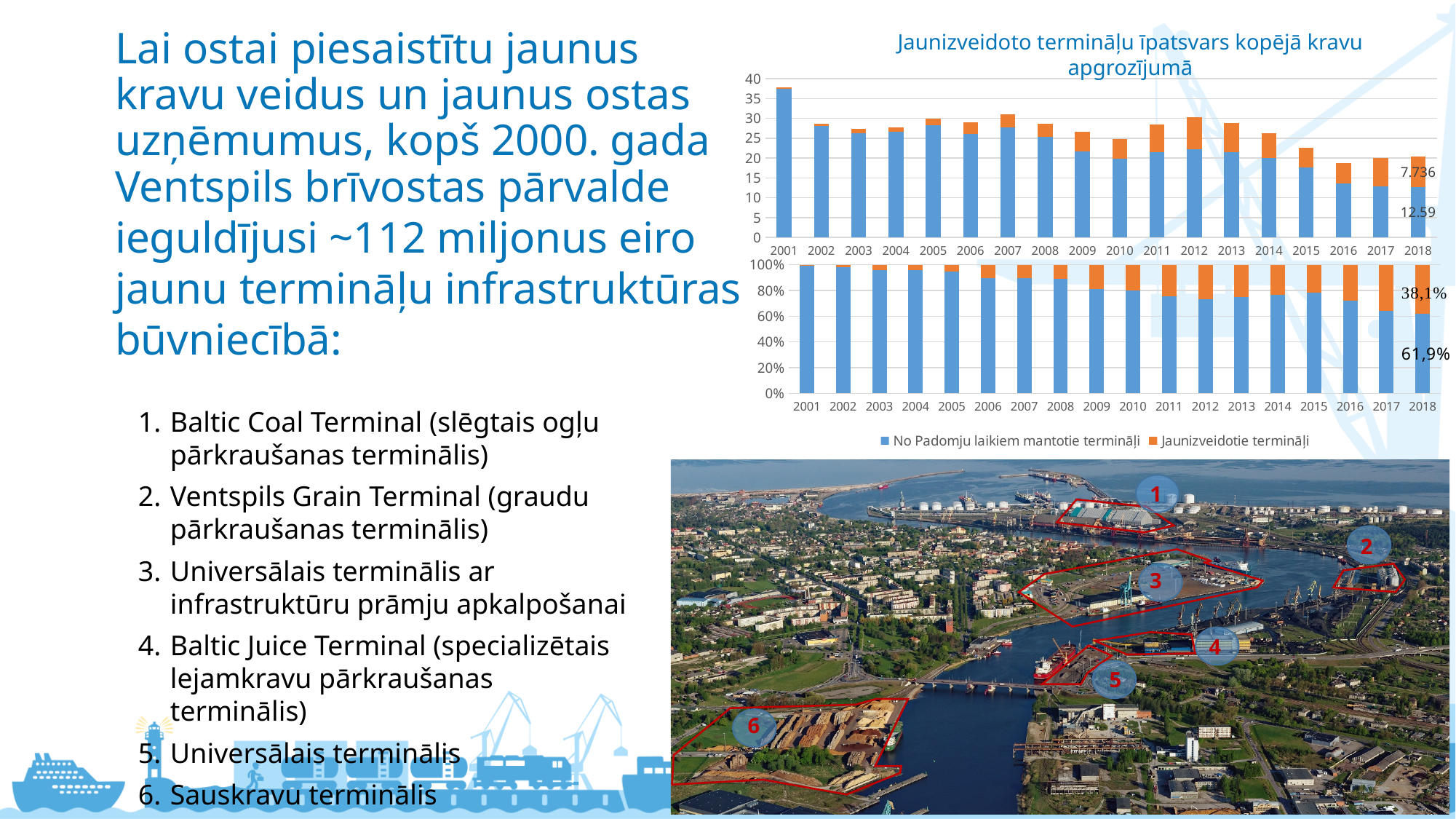
In the top chart, what is the value for Jaunizveidotie termināļi in 2018? 7.736 In the top chart, which year has the highest total bar? 2001 In the top chart, what is the difference between the 2018 values of No Padomju laikiem mantotie termināļi and Jaunizveidotie termināļi? 4.854 In the bottom (percentage) chart, by how many percentage points does the 2018 share of No Padomju laikiem mantotie termināļi exceed that of Jaunizveidotie termināļi? 23,8% In the bottom (percentage) chart, what share do Jaunizveidotie termināļi have in 2018? 38,1% How many years are shown on the x axis of the top chart? 18 How many series does the legend list for the charts? 2 What kind of chart is the top chart? Stacked bar chart In the bottom (percentage) chart, what share do No Padomju laikiem mantotie termināļi have in 2018? 61,9% In the top chart, what is the value for No Padomju laikiem mantotie termināļi in 2018? 12.59 In the top chart, is the total value for 2016 greater or less than 20? less In the bottom (percentage) chart, does the share of Jaunizveidotie termināļi generally rise or fall from 2001 to 2018? rise